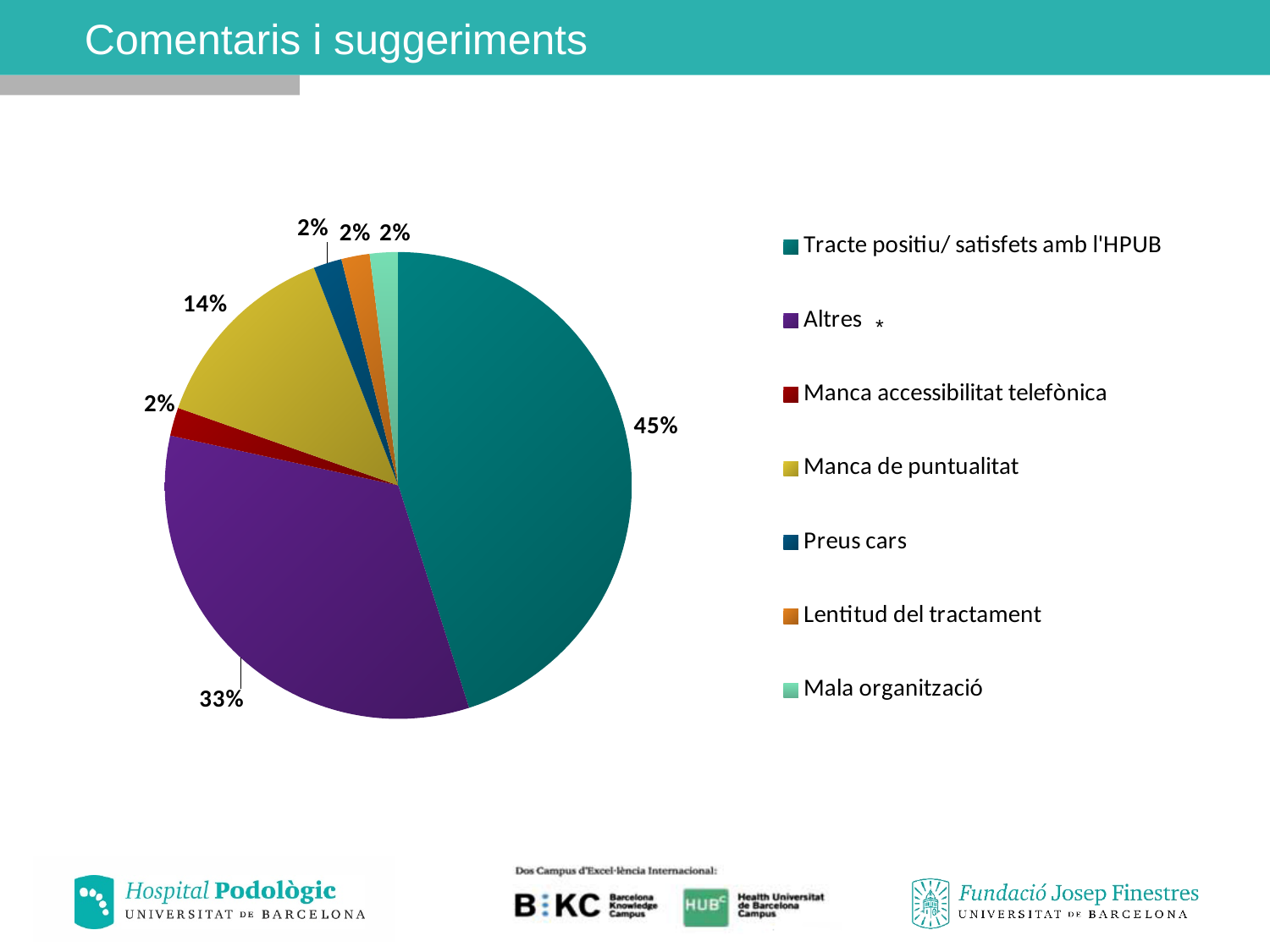
What kind of chart is shown on the slide? pie chart What share of the pie does "Altres" represent? 33% Which is larger, the share for "Altres" or the share for "Manca de puntualitat"? Altres What is the title of the slide containing the pie chart? Comentaris i suggeriments How many categories have a share of 2%? 4 What share of the pie does "Manca accessibilitat telefònica" represent? 2% What share of the pie does "Tracte positiu/ satisfets amb l'HPUB" represent? 45% What is the difference between the shares for "Tracte positiu/ satisfets amb l'HPUB" and "Altres"? 12% How many categories does the legend list? 7 What share of the pie does "Manca de puntualitat" represent? 14% Which category has the largest slice of the pie? Tracte positiu/ satisfets amb l'HPUB What is the difference between the shares for "Manca de puntualitat" and "Preus cars"? 12%